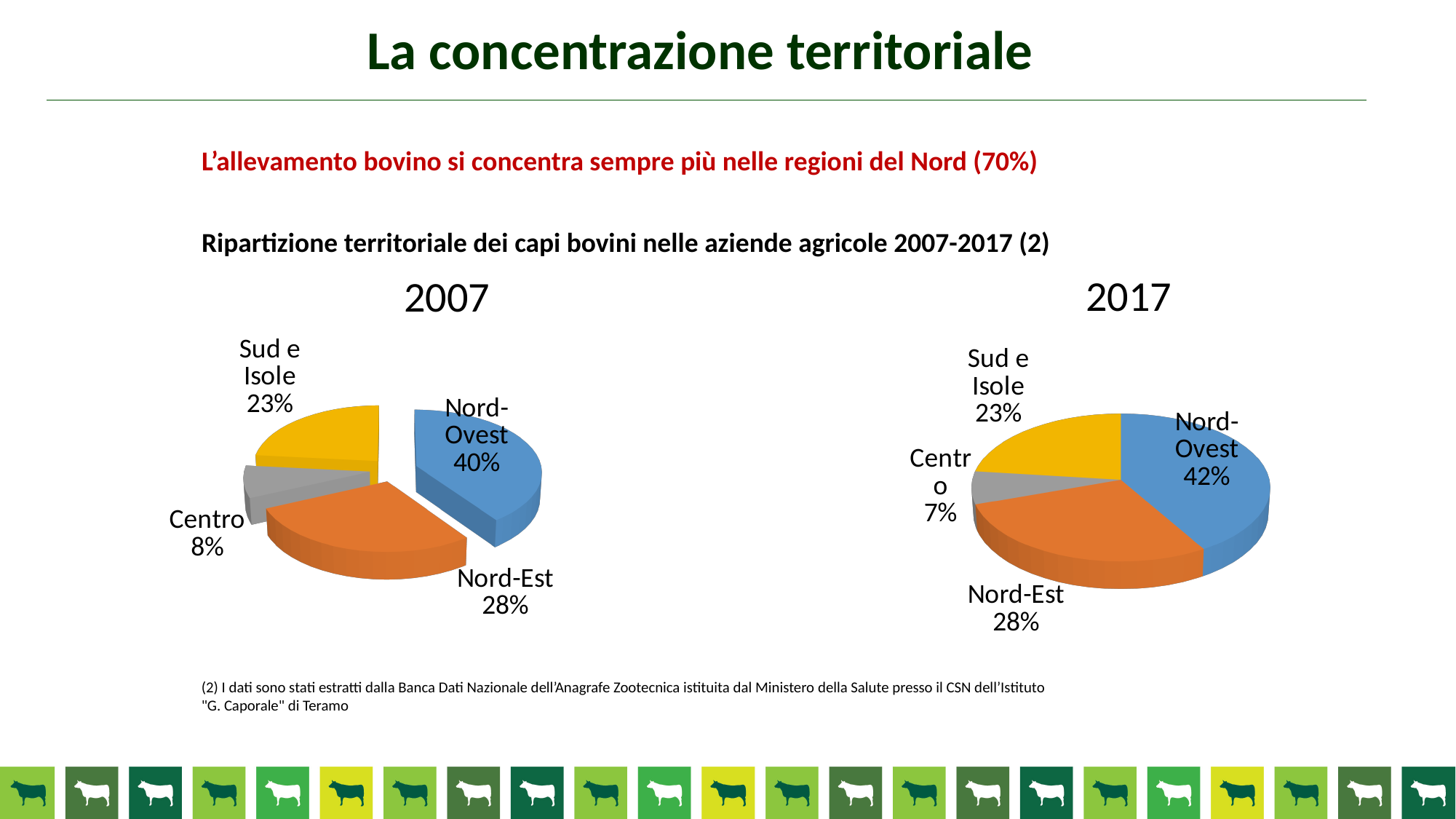
In the 2007 pie chart, what share does Centro have? 8% In the 2017 pie chart, which is larger: Sud e Isole or Nord-Est? Nord-Est In the 2007 pie chart, what share does Nord-Ovest have? 40% In the 2017 pie chart, what share does Centro have? 7% What colour is the Sud e Isole slice in both pie charts? Yellow In the 2017 pie chart, which region has the largest share? Nord-Ovest What type of chart is used for the 2017 data? Pie chart In the 2007 pie chart, which region has the smallest share? Centro How many slices does the 2007 pie chart have? 4 In the 2017 pie chart, what share does Nord-Ovest have? 42% In the 2007 pie chart, what is the difference between the Nord-Ovest and Nord-Est shares? 12% In the 2017 pie chart, what is the combined share of Nord-Ovest and Nord-Est? 70%